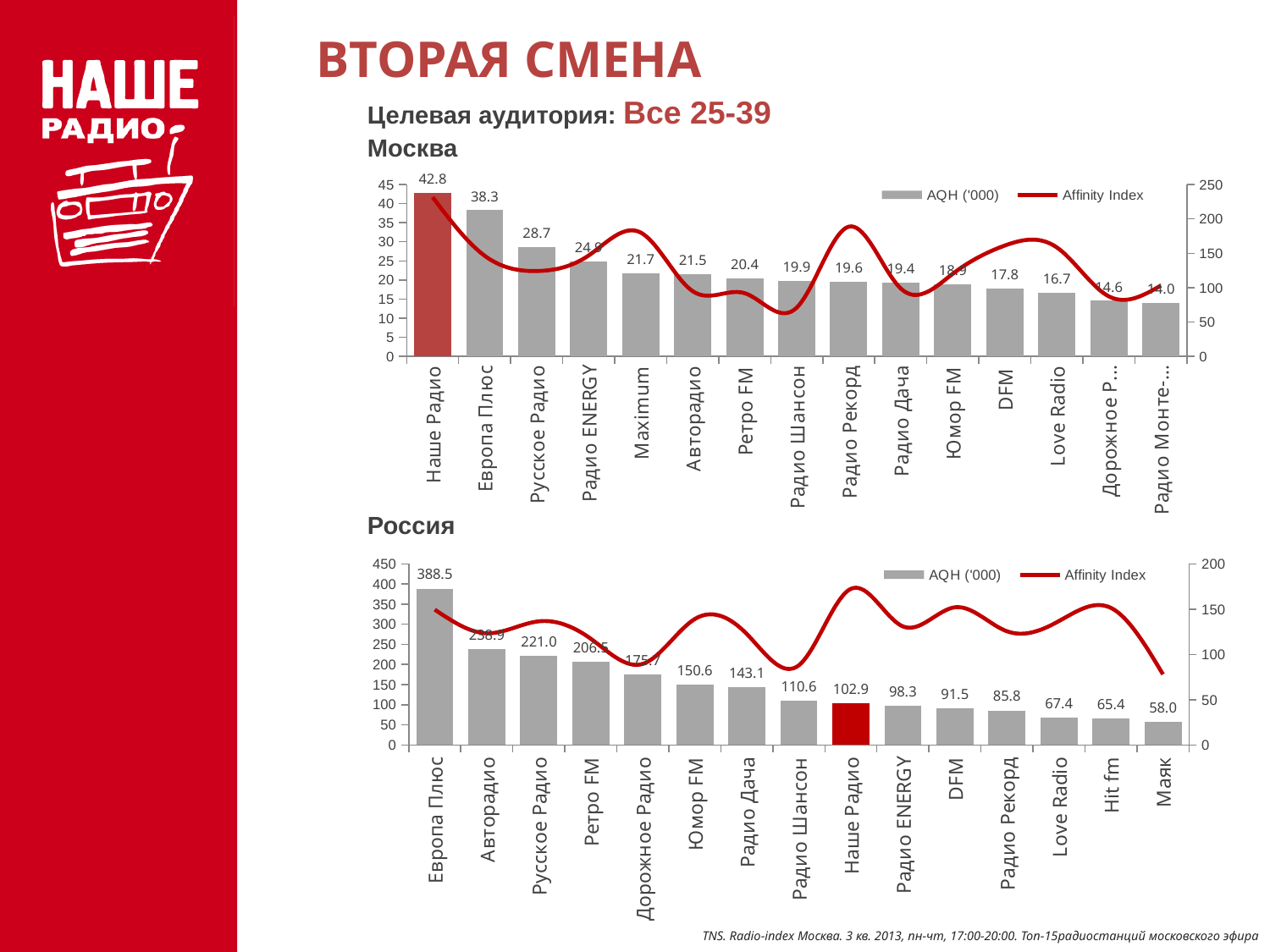
In the Москва chart, how many series does the legend list? 2 In the Россия chart, how many stations are shown on the x axis? 15 In the Россия chart, do the AQH ('000) bars rise or fall from left to right? fall In the Россия chart, what is the difference in AQH ('000) between Юмор FM and Радио Дача? 7.5 In the Москва chart, what is the AQH ('000) value for Наше Радио? 42.8 In the Москва chart, which has the larger AQH ('000) bar, Maximum or DFM? Maximum In the Россия chart, what is the AQH ('000) value for Европа Плюс? 388.5 In the Россия chart, which station has the lowest AQH ('000) bar? Маяк In the Москва chart, what is the AQH ('000) value for Русское Радио? 28.7 In the Москва chart, what is the difference in AQH ('000) between Наше Радио and Европа Плюс? 4.5 In the Москва chart, which station has the highest AQH ('000) bar? Наше Радио In the Россия chart, what is the AQH ('000) value for Наше Радио? 102.9